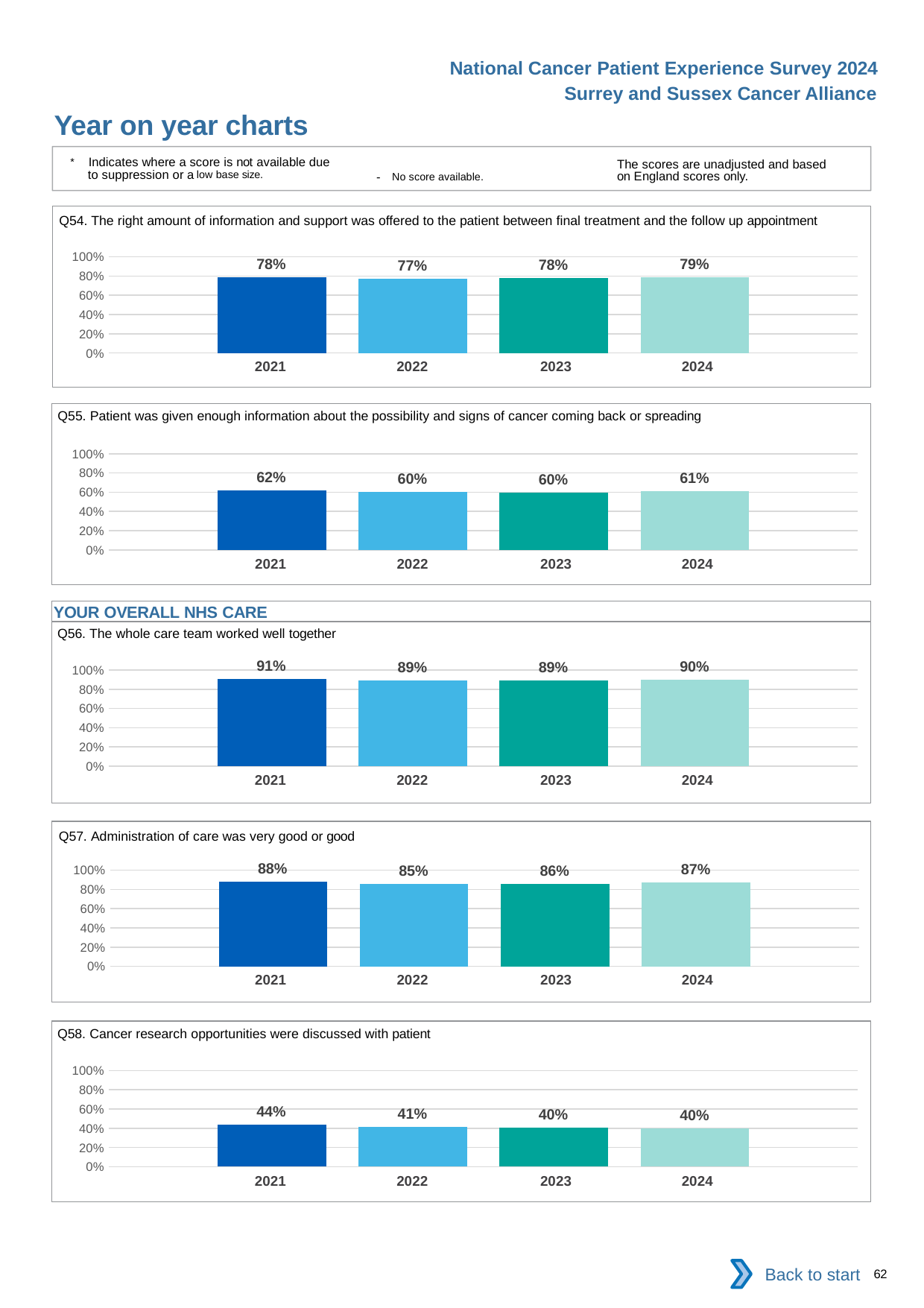
In the Q54 chart, what is the value for 2024? 79% In the Q58 chart, is the value for 2021 larger or smaller than the value for 2022? larger What type of chart is the Q56 chart? bar chart What is the section heading shown above the Q56 chart? YOUR OVERALL NHS CARE In the Q58 chart, is the value for 2023 greater or less than 60%? less In the Q55 chart, which year has the highest value? 2021 How many bars are shown in the Q57 chart? 4 In the Q58 chart, what is the value for 2021? 44% In the Q57 chart, which year has the lowest value? 2022 In the Q57 chart, what is the difference between the 2021 and 2024 values? 1% In the Q55 chart, what is the value for 2023? 60% In the Q56 chart, what is the difference between the 2021 and 2022 values? 2%